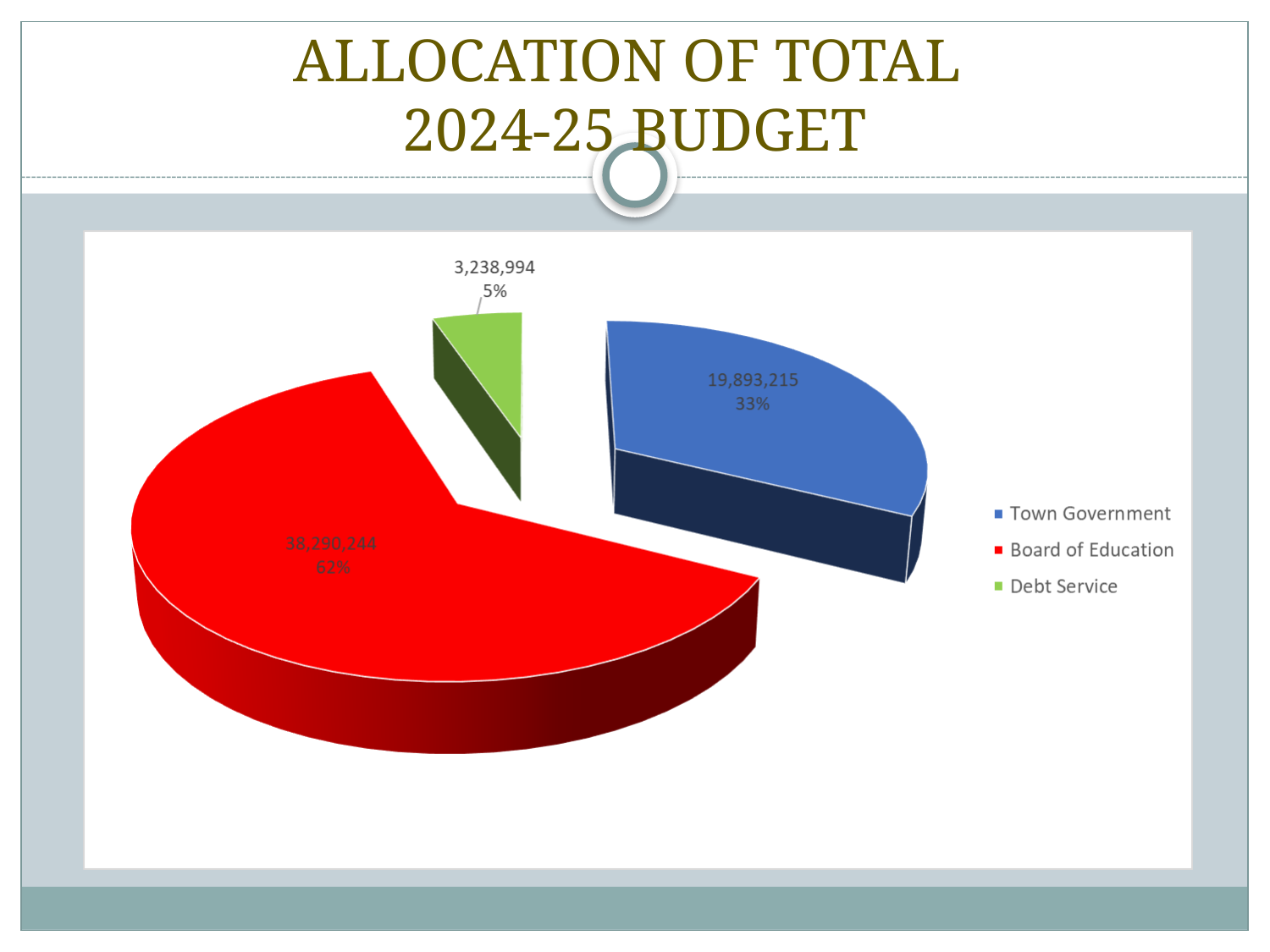
How many categories does the legend list? 3 What share of the pie does Town Government represent? 33% What is the value for Board of Education? 38,290,244 What share of the pie does Board of Education represent? 62% Which category has the largest slice? Board of Education What share of the pie does Debt Service represent? 5% Which category has the smallest slice? Debt Service What is the value for Town Government? 19,893,215 What kind of chart is shown on the slide? Pie chart Which is larger, Town Government or Debt Service? Town Government What is the difference between the Board of Education value and the Town Government value? 18,397,029 What is the value for Debt Service? 3,238,994